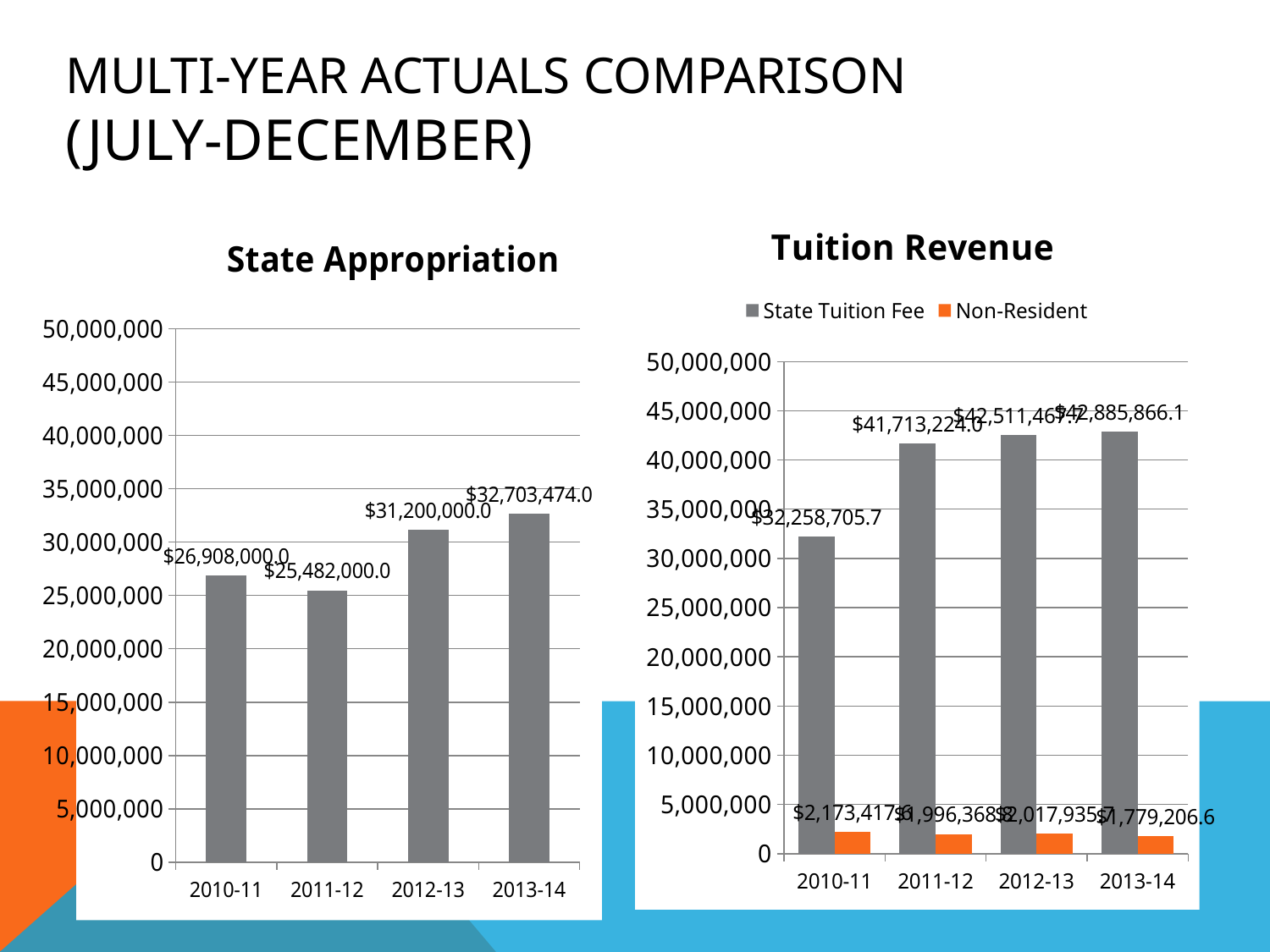
How many series does the legend of the Tuition Revenue chart list? 2 In the State Appropriation chart, which year has the lowest value? 2011-12 In the Tuition Revenue chart, is the State Tuition Fee value larger in 2010-11 or 2011-12? 2011-12 In the State Appropriation chart, which year has the highest value? 2013-14 In the State Appropriation chart, what is the difference between the 2013-14 and 2012-13 values? $1,503,474.0 In the State Appropriation chart, what is the value for 2011-12? $25,482,000.0 In the Tuition Revenue chart, what is the State Tuition Fee value for 2010-11? $32,258,705.7 How many years are shown in the State Appropriation chart? 4 In the Tuition Revenue chart, is the Non-Resident value for 2012-13 greater or less than 5,000,000? less In the Tuition Revenue chart, what is the Non-Resident value for 2013-14? $1,779,206.6 What kind of chart is the State Appropriation chart? bar chart In the State Appropriation chart, what is the value for 2013-14? $32,703,474.0